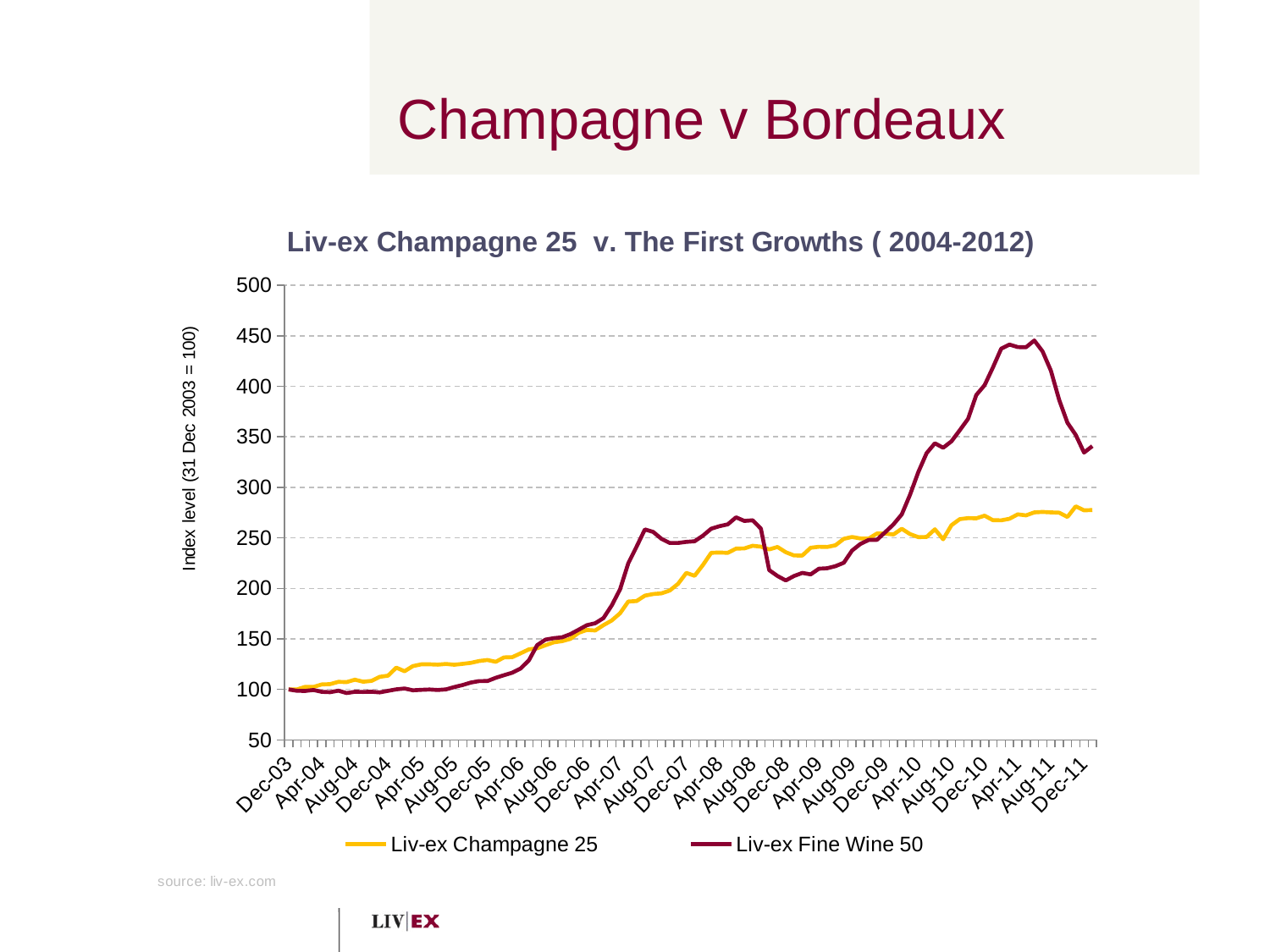
Is the value for Liv-ex Fine Wine 50 at Apr-11 greater or less than 400? greater What is the label on the vertical axis? Index level (31 Dec 2003 = 100) What kind of chart is shown on the slide? line chart Which series reaches the highest index level anywhere on the chart? Liv-ex Fine Wine 50 What is the title of the chart? Liv-ex Champagne 25 v. The First Growths ( 2004-2012) Is the value for Liv-ex Fine Wine 50 at Dec-08 greater or less than 250? less Does the Liv-ex Fine Wine 50 series rise or fall between Apr-11 and Dec-11? fall At Apr-11, which series has the higher index level? Liv-ex Fine Wine 50 What is the index level of both series at Dec-03? 100 Is the value for Liv-ex Champagne 25 at Dec-11 greater or less than 300? less At Apr-05, which series has the higher index level? Liv-ex Champagne 25 How many series does the legend list? 2